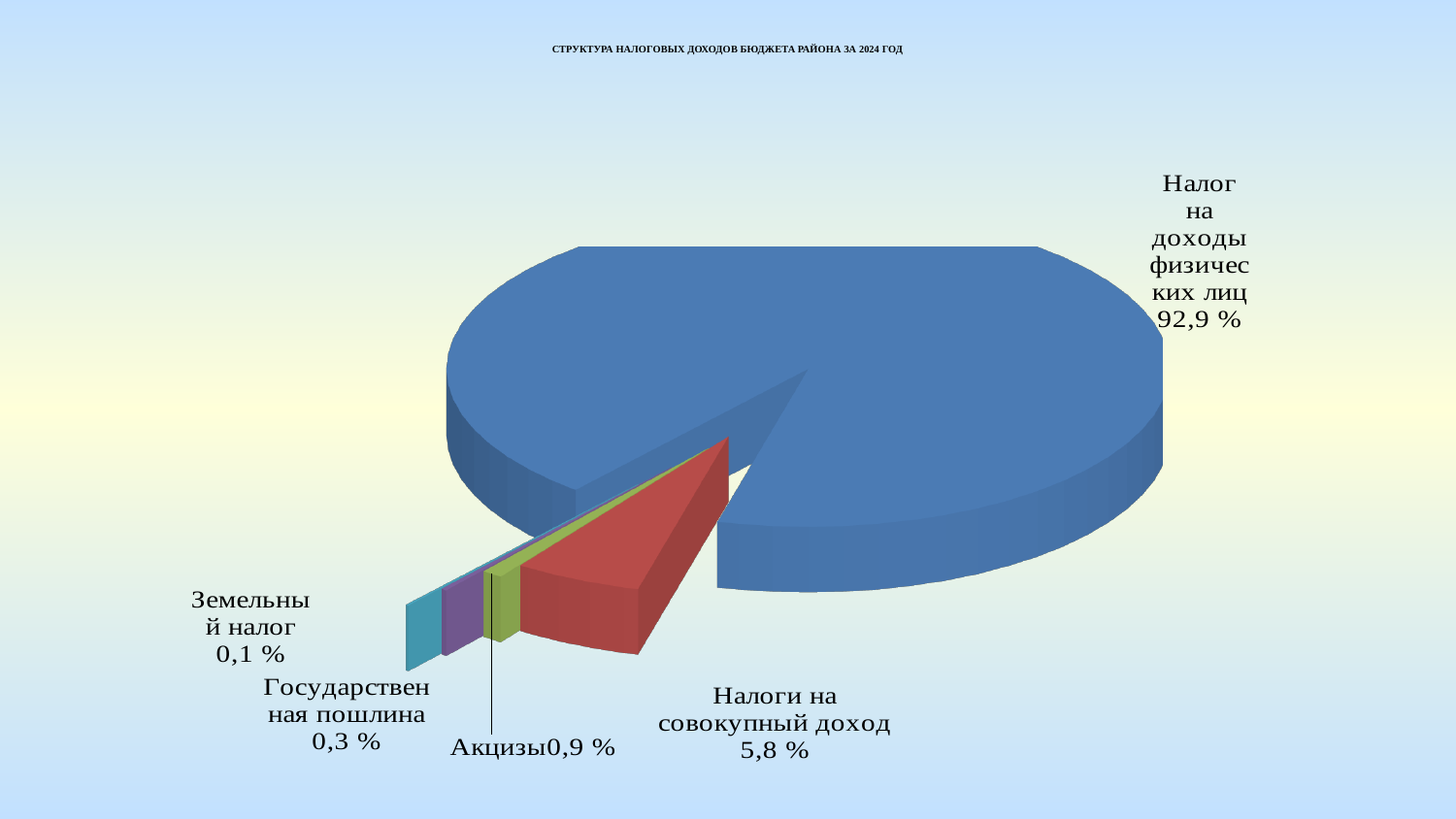
What is the share of Государственная пошлина? 0,3 % What is the share of Акцизы? 0,9 % What is the share of Земельный налог? 0,1 % Which category has the largest slice of the pie? Налог на доходы физических лиц What is the difference between the shares of Налоги на совокупный доход and Акцизы? 4,9 % How many slices does the pie chart have? 5 Which is larger, the share of Государственная пошлина or the share of Земельный налог? Государственная пошлина What is the share of Налог на доходы физических лиц in the pie chart? 92,9 % What is the title of the chart? СТРУКТУРА НАЛОГОВЫХ ДОХОДОВ БЮДЖЕТА РАЙОНА ЗА 2024 ГОД What is the share of Налоги на совокупный доход? 5,8 % Which category has the smallest slice of the pie? Земельный налог What kind of chart is shown on the slide? Pie chart